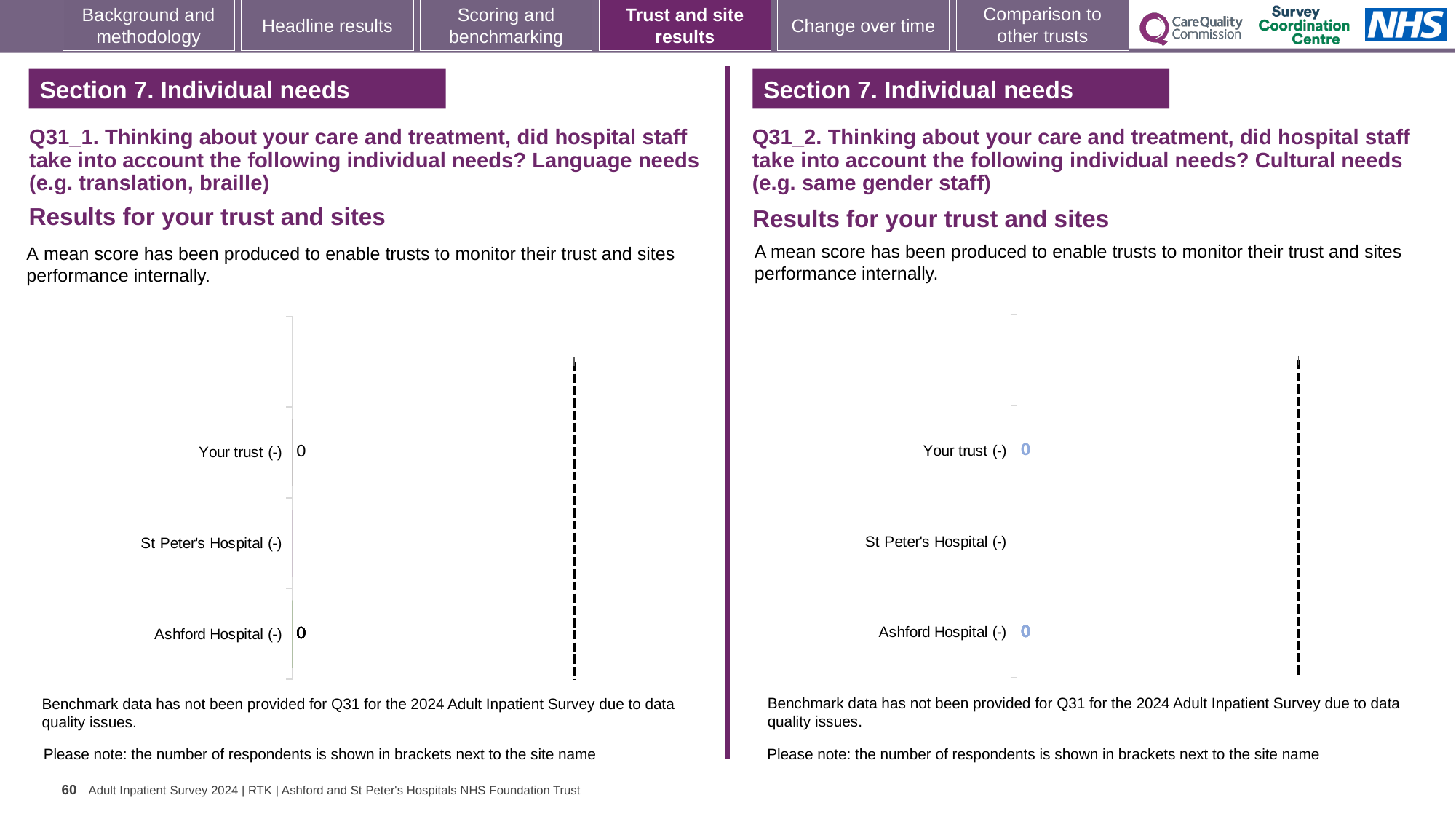
What kind of chart is used on the left side of the slide for Q31_1? Bar chart In the left chart (Q31_1, Language needs), what value is shown for Your trust (-)? 0 In the left chart (Q31_1), what is the difference between the values for Your trust (-) and Ashford Hospital (-)? 0 How many categories are listed on the vertical axis of the right chart (Q31_2)? 3 Which category appears in the middle of the vertical axis in the right chart (Q31_2)? St Peter's Hospital (-) How many categories are listed on the vertical axis of the left chart (Q31_1)? 3 In the left chart (Q31_1, Language needs), what value is shown for Ashford Hospital (-)? 0 According to the note below the charts, why has benchmark data not been provided for Q31? Due to data quality issues In the right chart (Q31_2, Cultural needs), what value is shown for Your trust (-)? 0 In the right chart (Q31_2, Cultural needs), what value is shown for Ashford Hospital (-)? 0